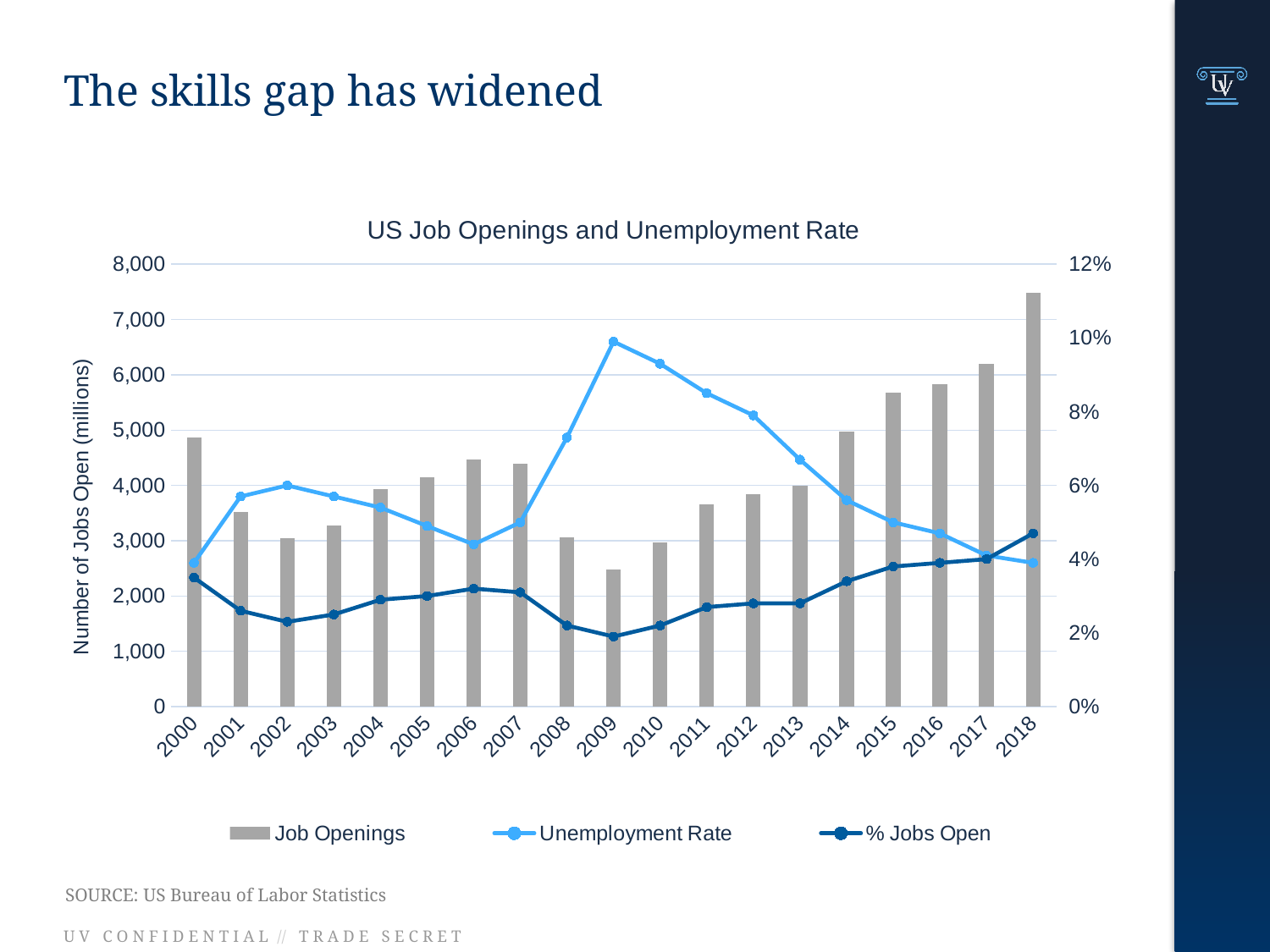
What kind of chart is shown on the slide? A combination bar and line chart How many years are shown on the x axis? 19 Is the Job Openings value for 2009 greater or less than 3,000? less Which year has the lowest number of job openings? 2009 In which year is the % Jobs Open line at its lowest? 2009 How many series does the legend list? 3 Which year has more job openings, 2000 or 2001? 2000 In which year does the Unemployment Rate peak? 2009 Is the Unemployment Rate for 2009 greater or less than 8%? greater Is the Job Openings value for 2018 greater or less than 7,000? greater Which year has the highest number of job openings? 2018 Do job openings rise or fall from 2009 to 2018? rise